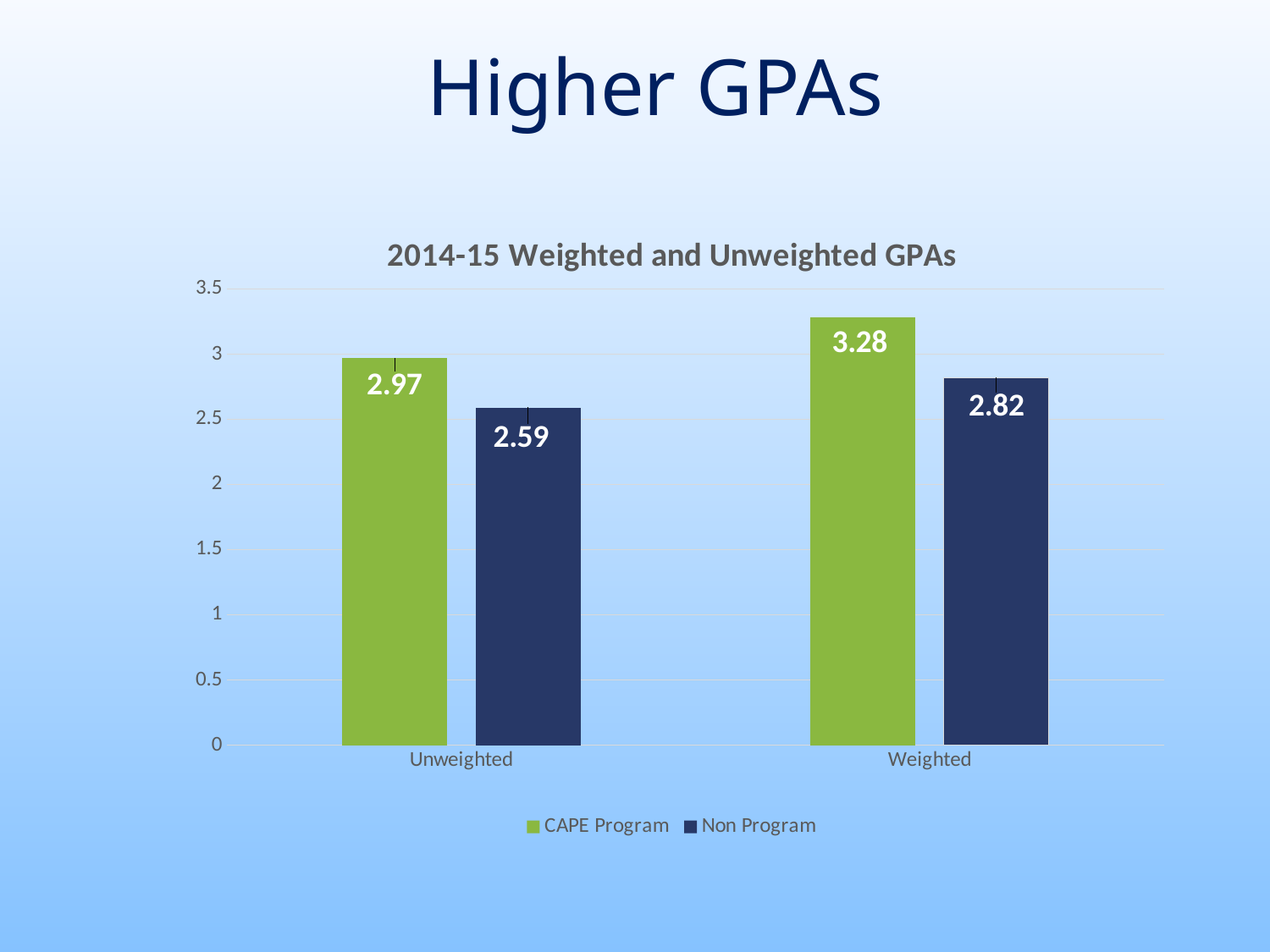
Which bar shows the highest GPA on the chart? CAPE Program, Weighted What is the difference between the CAPE Program and Non Program Unweighted GPAs? 0.38 What is the difference between the CAPE Program and Non Program Weighted GPAs? 0.46 Which bar shows the lowest GPA on the chart? Non Program, Unweighted What is the Weighted GPA for the Non Program group? 2.82 Which is larger, the CAPE Program Unweighted GPA or the Non Program Weighted GPA? CAPE Program Unweighted GPA How many categories are shown on the x axis? 2 What is the title of the chart? 2014-15 Weighted and Unweighted GPAs How many series does the legend list? 2 What kind of chart is shown on the slide? Bar chart What is the Unweighted GPA for the Non Program group? 2.59 What is the Unweighted GPA for the CAPE Program? 2.97